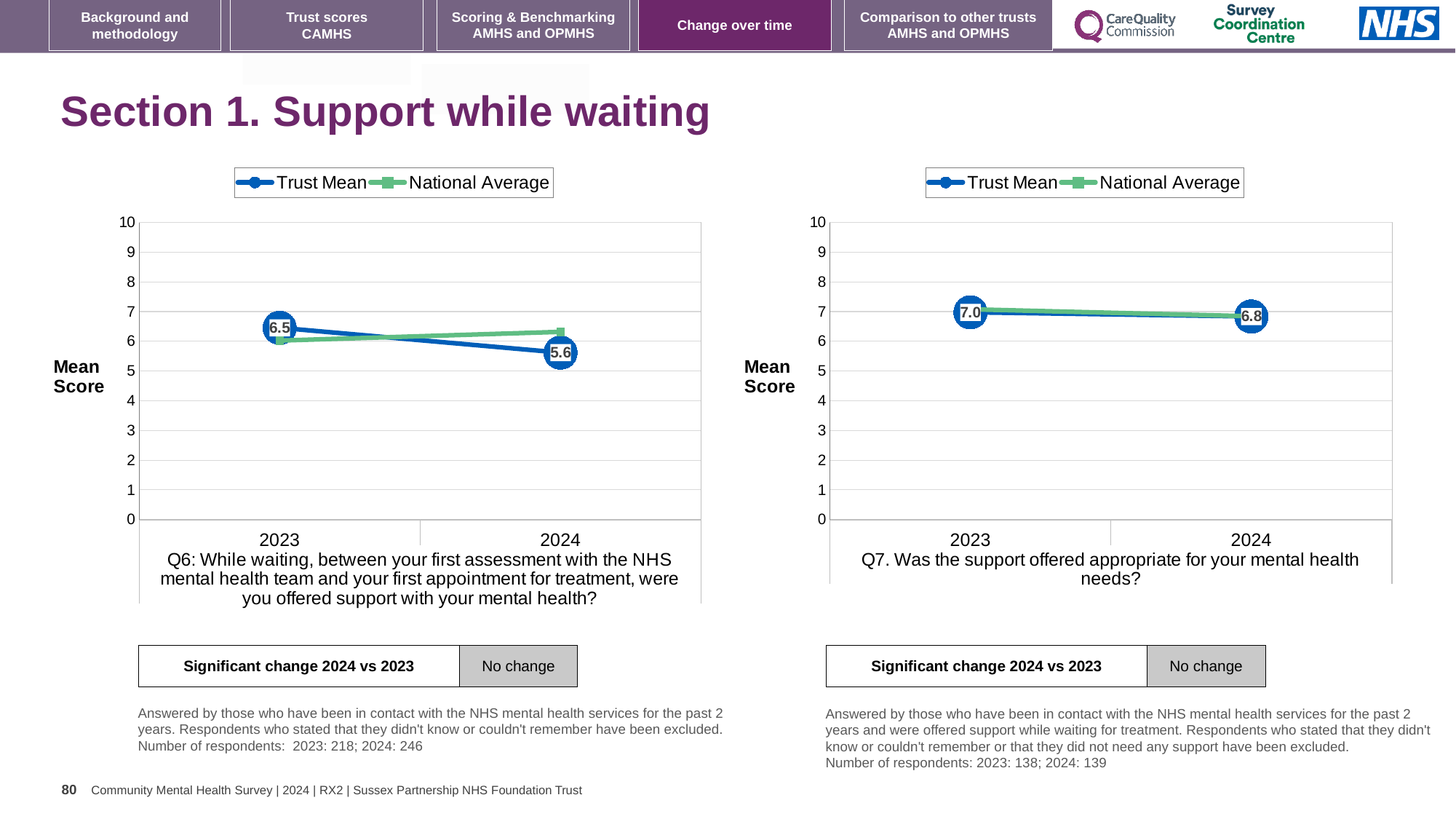
In the Q7 chart on the right, what is the Trust Mean for 2023? 7.0 In the Q6 chart on the left, what is the Trust Mean for 2024? 5.6 In the Q6 chart on the left, is the National Average for 2024 greater or less than 6? greater In the Q7 chart on the right, what is the difference between the Trust Mean in 2023 and 2024? 0.2 In the Q6 chart on the left, by how much did the Trust Mean change from 2023 to 2024? 0.9 How many series does the legend of the Q6 chart on the left list? 2 In the Q7 chart on the right, which year has the higher Trust Mean, 2023 or 2024? 2023 What type of chart is used for Q7 on the right? line chart How many years are shown on the x axis of the Q7 chart on the right? 2 In the Q6 chart on the left, what is the Trust Mean for 2023? 6.5 In the Q7 chart on the right, what is the Trust Mean for 2024? 6.8 In the Q6 chart on the left, does the Trust Mean rise or fall from 2023 to 2024? fall